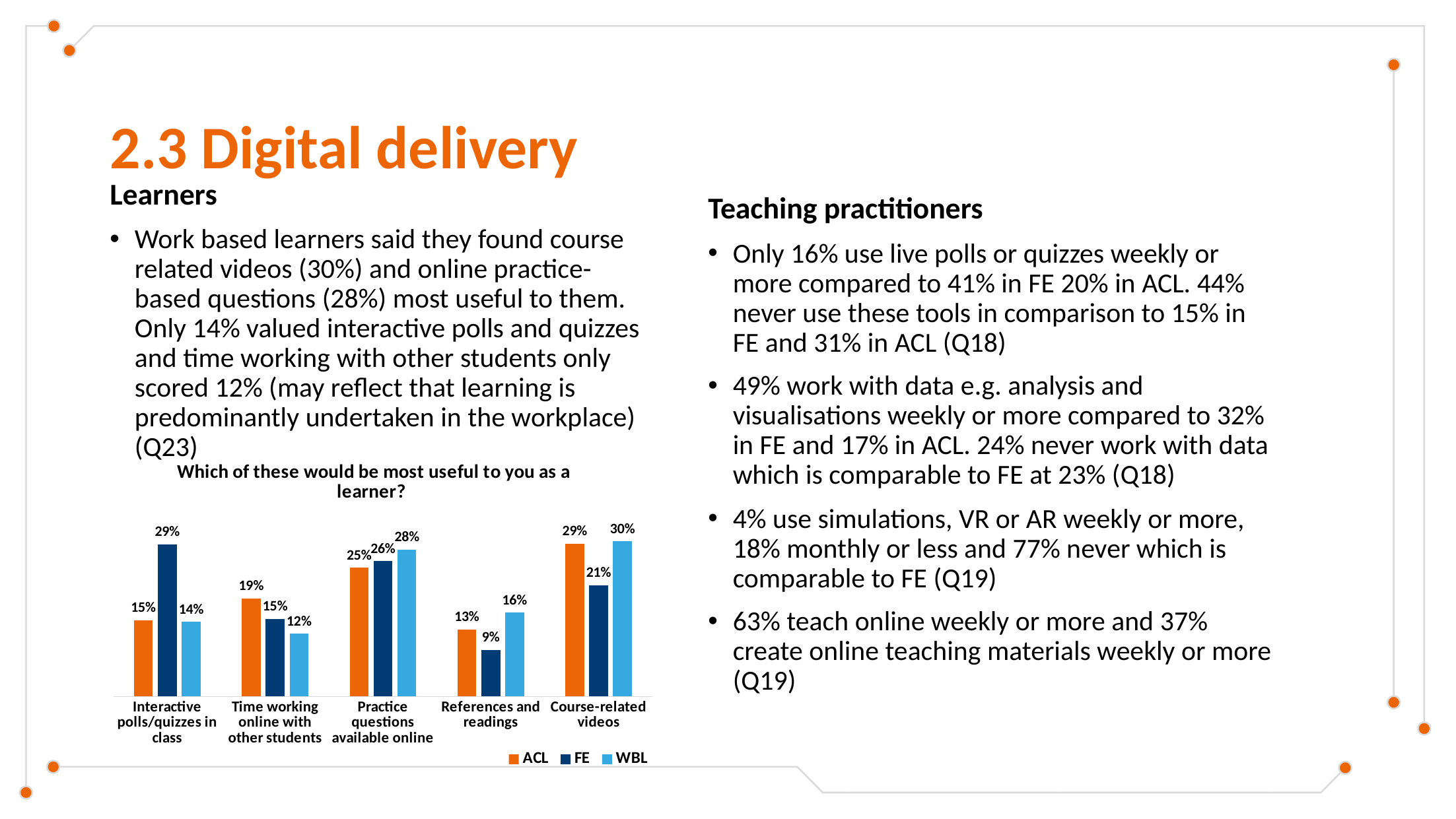
Which category has the highest WBL value? Course-related videos What kind of chart is shown on the slide? Bar chart Which series is shown in orange in the legend? ACL What is the ACL value for Time working online with other students? 19% What is the difference between the FE and WBL values for Interactive polls/quizzes in class? 15% How many series does the legend list? 3 How many categories are shown on the x axis? 5 Which is larger for References and readings: the ACL value or the WBL value? WBL What is the FE value for Interactive polls/quizzes in class? 29% What is the WBL value for Course-related videos? 30% What is the title of the chart? Which of these would be most useful to you as a learner? Which category has the lowest FE value? References and readings